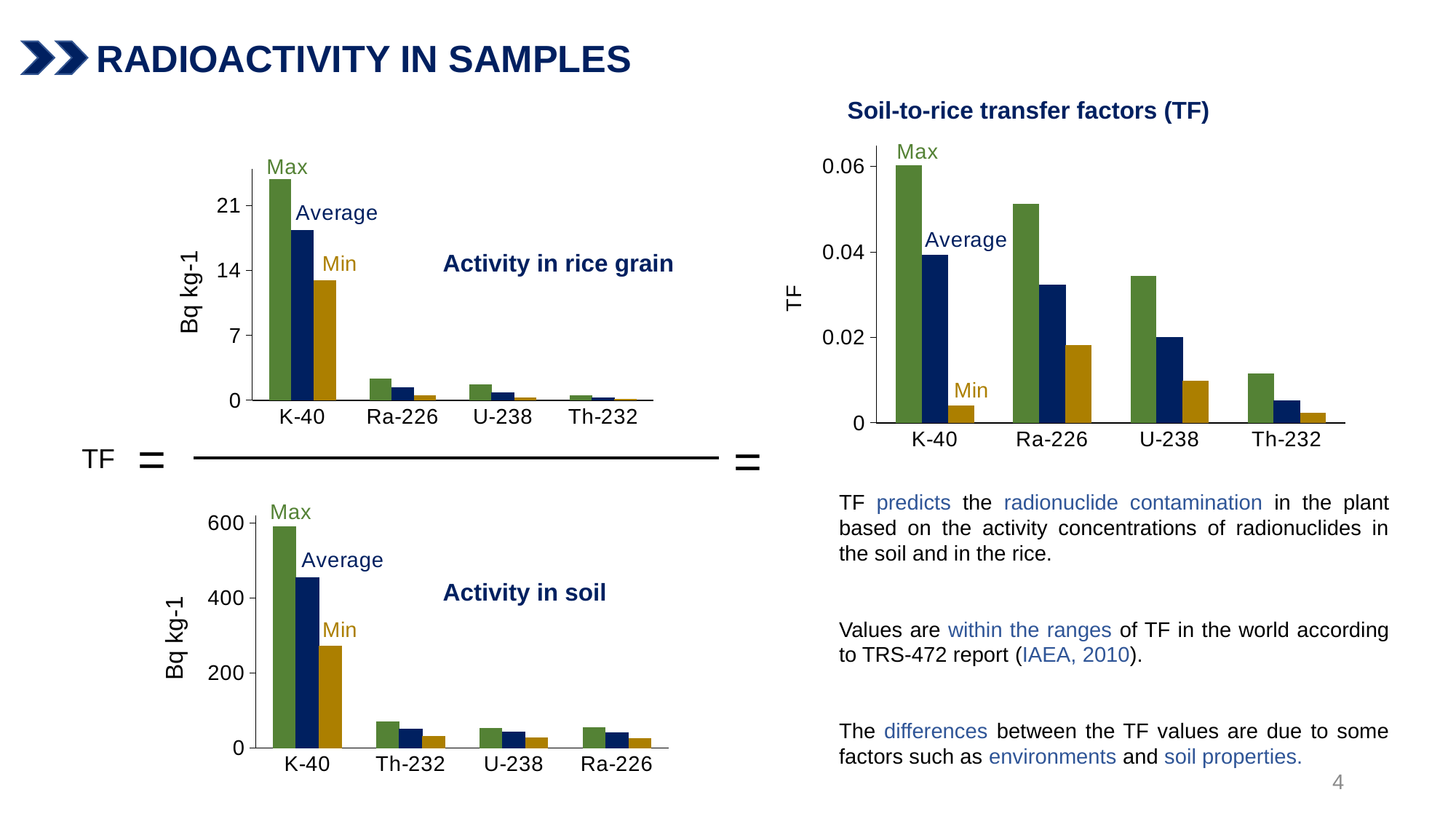
In the 'Activity in rice grain' chart, which radionuclide has the highest Max value? K-40 In the 'Soil-to-rice transfer factors (TF)' chart, which radionuclide has the lowest Max value? Th-232 In the 'Activity in rice grain' chart, how many radionuclide categories are shown on the x axis? 4 In the 'Activity in rice grain' chart, is the Average value for K-40 greater or less than 14? greater In the 'Activity in soil' chart, how many series are plotted for each radionuclide? 3 In the 'Soil-to-rice transfer factors (TF)' chart, is the Max value for U-238 greater or less than 0.04? less In the 'Activity in rice grain' chart, is the Max value for K-40 greater or less than 21? greater What kind of chart is the 'Activity in rice grain' chart? bar chart In the 'Activity in rice grain' chart, which radionuclide has the lowest Max value? Th-232 In the 'Soil-to-rice transfer factors (TF)' chart, is the Max value for Ra-226 larger or smaller than the Max value for U-238? larger